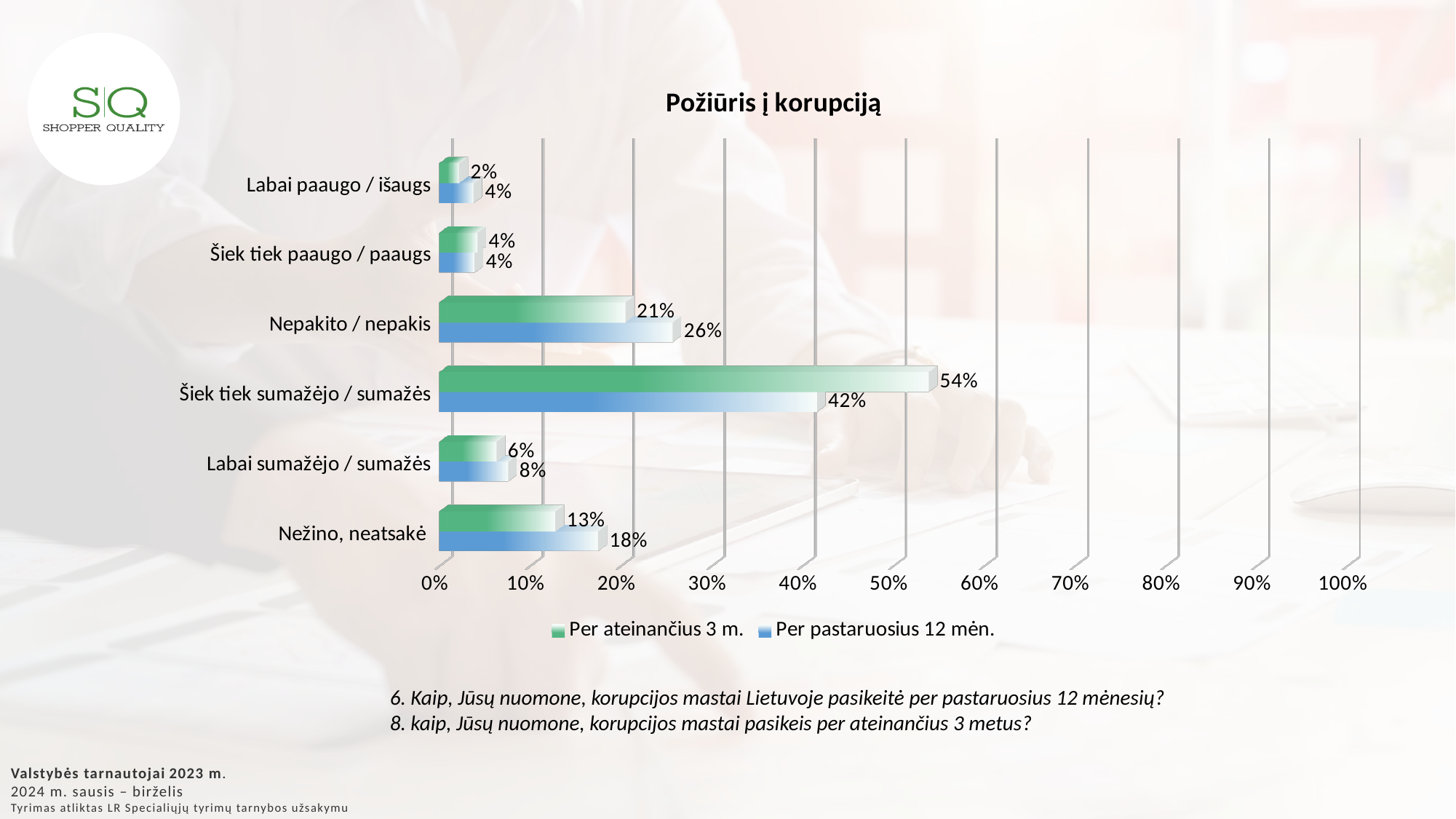
What is the value for "Nežino, neatsakė" in the "Per pastaruosius 12 mėn." series? 18% For "Nepakito / nepakis", which series has the larger value: "Per ateinančius 3 m." or "Per pastaruosius 12 mėn."? Per pastaruosius 12 mėn. How many series does the legend list? 2 What kind of chart is shown on the slide? Bar chart Is the "Per pastaruosius 12 mėn." value for "Šiek tiek sumažėjo / sumažės" greater or less than 40%? greater What is the title of the chart? Požiūris į korupciją What is the difference between the "Per ateinančius 3 m." and "Per pastaruosius 12 mėn." values for "Šiek tiek sumažėjo / sumažės"? 12% How many categories are shown on the chart? 6 Which category has the highest value in the "Per ateinančius 3 m." series? Šiek tiek sumažėjo / sumažės What is the value for "Šiek tiek sumažėjo / sumažės" in the "Per ateinančius 3 m." series? 54% What is the value for "Nepakito / nepakis" in the "Per pastaruosius 12 mėn." series? 26% Which category has the lowest value in the "Per ateinančius 3 m." series? Labai paaugo / išaugs